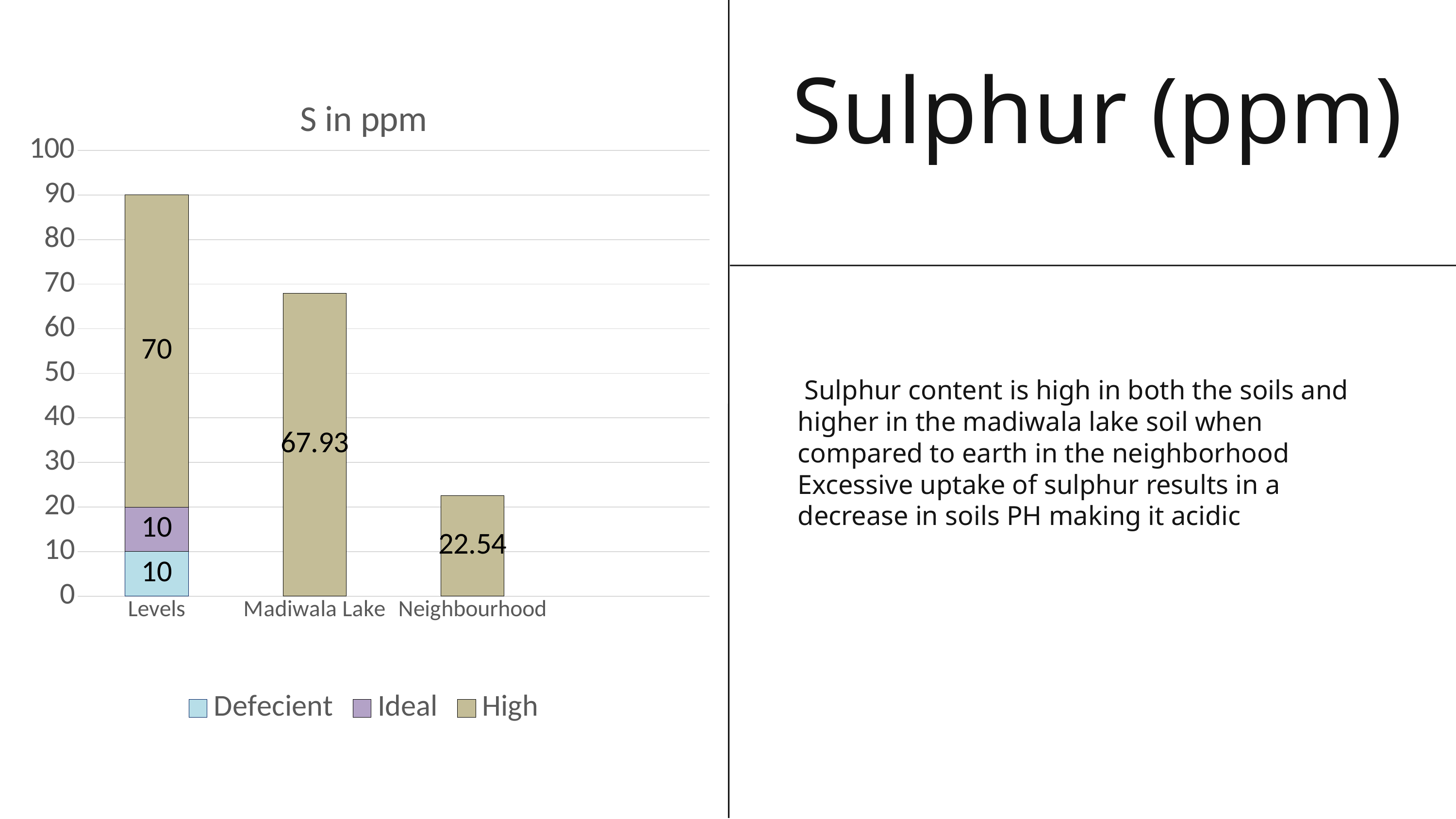
What is the High value for Neighbourhood? 22.54 How many series does the legend list? 3 What is the title of the chart? S in ppm Which has the larger High value, Madiwala Lake or Neighbourhood? Madiwala Lake What is the difference between the High values for Madiwala Lake and Neighbourhood? 45.39 Which series is shown in the light blue colour in the legend? Defecient What is the High value for Madiwala Lake? 67.93 What is the Defecient value for Levels? 10 How many categories are shown on the x axis? 3 What is the High value for Levels? 70 What is the total of the stacked bar for Levels? 90 What kind of chart is shown on the slide? stacked bar chart